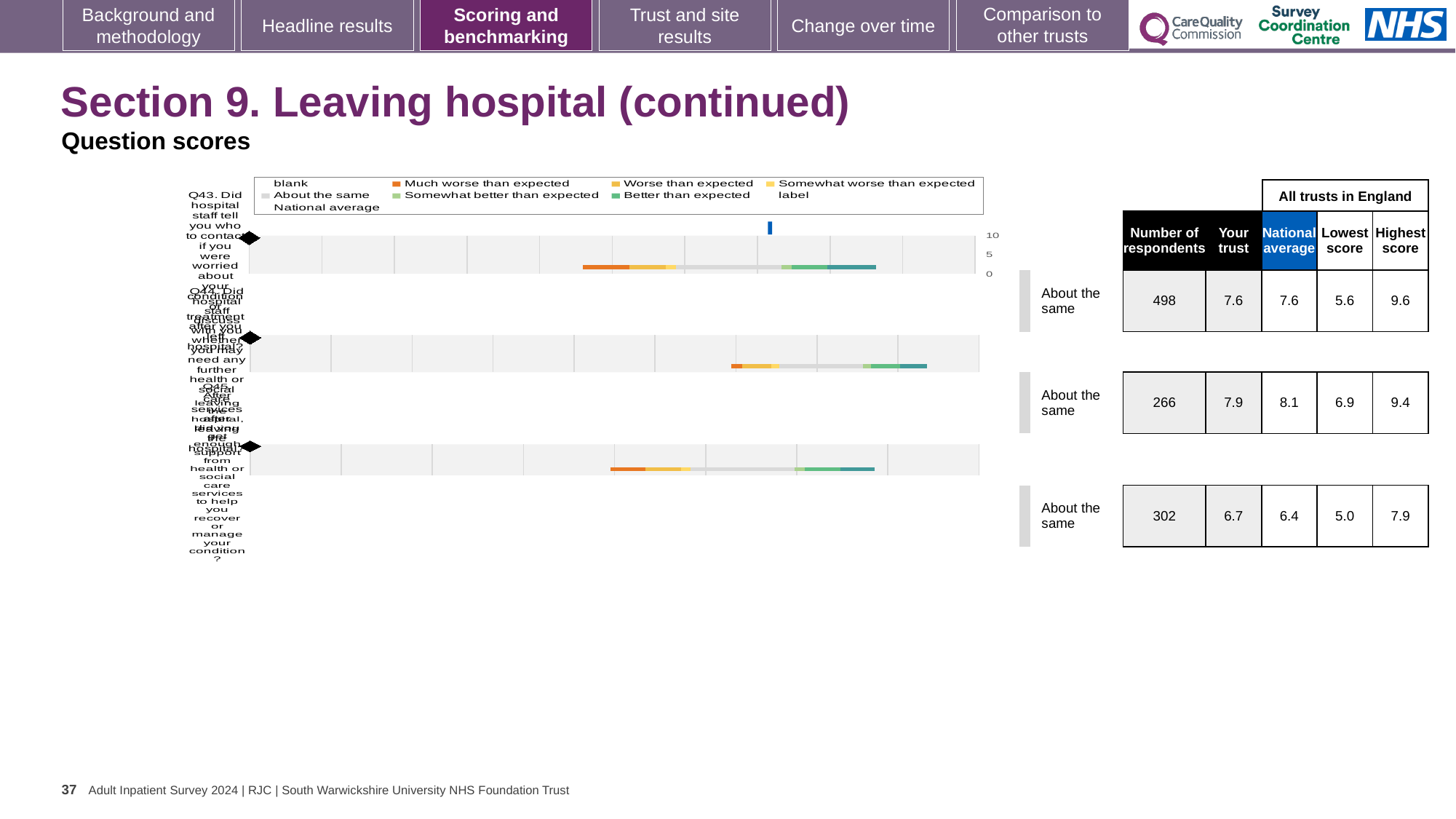
What is the number of respondents for Q43? 498 Which question has the highest 'Your trust' score? Q44 What kind of chart is shown on the slide? Bar chart What is the maximum value shown on the chart's score axis? 10 What is the national average score for Q45? 6.4 What benchmark category is shown for Q43? About the same For Q45, what is the difference between the highest score and the lowest score among all trusts in England? 2.9 What is the 'Your trust' score for Q44? 7.9 Which question has the lowest 'Your trust' score? Q45 How many questions (bars) are plotted in the chart? 3 For Q44, which is larger: the 'Your trust' score or the national average? National average What is the lowest score among all trusts in England for Q44? 6.9